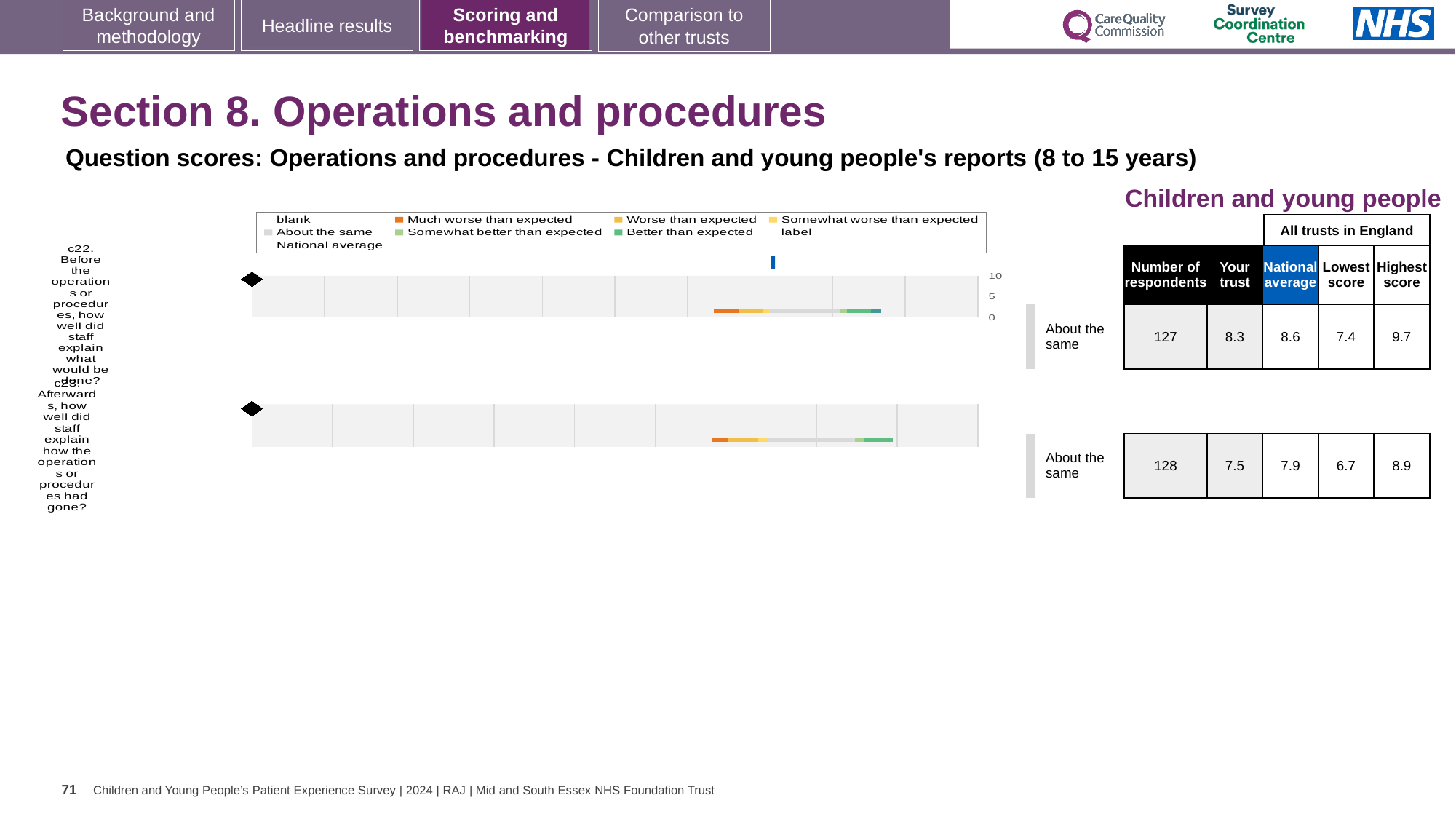
Which question has the higher 'Your trust' score, c22 or c23? c22 What is the highest score among all trusts in England for question c23? 8.9 What kind of chart is used to show the benchmark bands for questions c22 and c23? bar chart Is the 'Your trust' score for question c23 higher or lower than the national average? lower How many respondents answered question c22? 127 What is the 'Your trust' score for question c22 (Before the operations or procedures, how well did staff explain what would be done?)? 8.3 How many questions (bars) are plotted in the chart? 2 In the chart legend, which colour represents 'Much worse than expected'? orange What is the difference between the national average and the 'Your trust' score for question c22? 0.3 What is the national average score for question c23 (Afterwards, how well did staff explain how the operations or procedures had gone?)? 7.9 What benchmark category is shown for both c22 and c23? About the same What is the lowest score among all trusts in England for question c22? 7.4